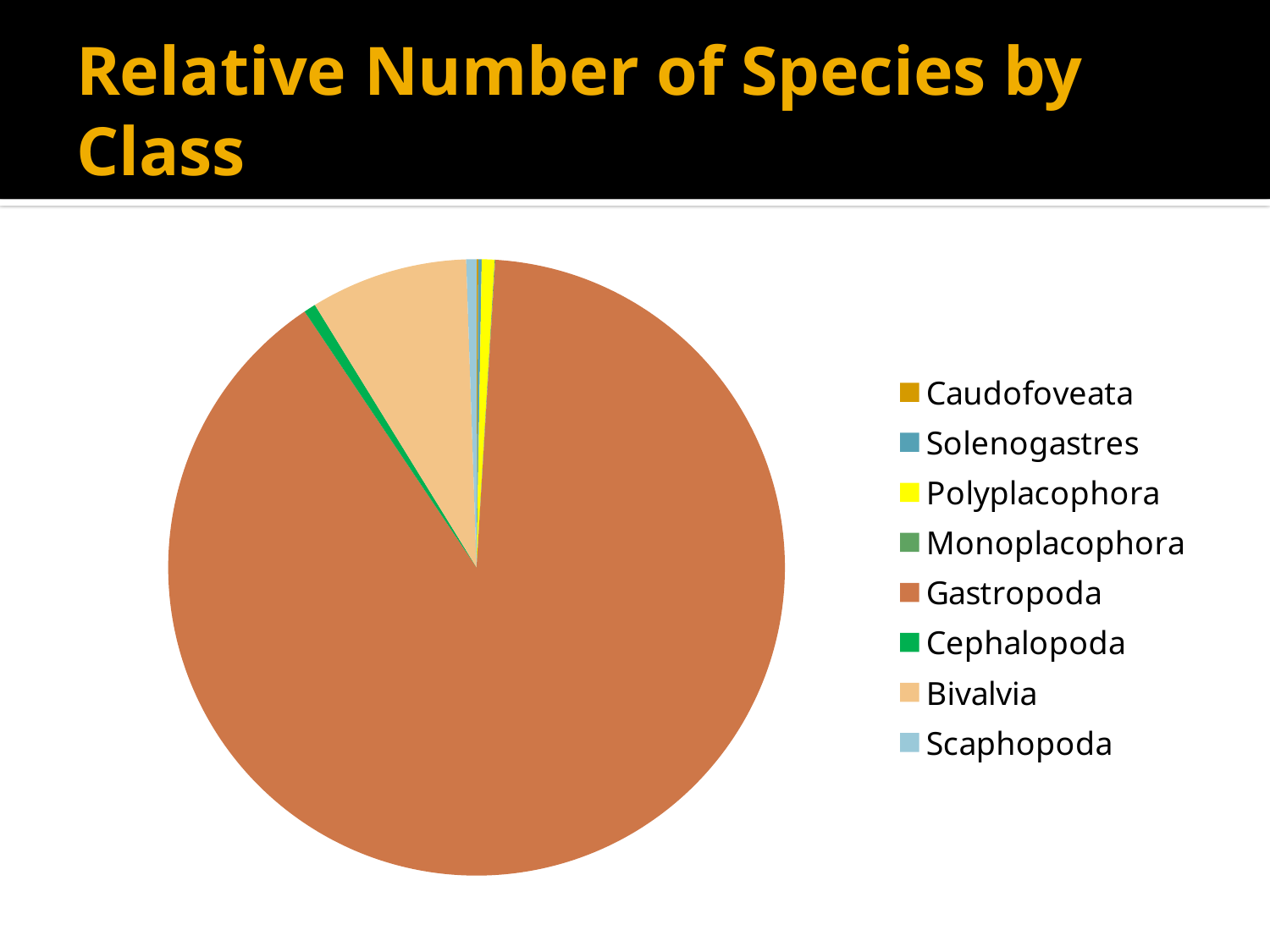
Which slice is larger, Bivalvia or Polyplacophora? Bivalvia Which class has the second-largest slice of the pie chart? Bivalvia What kind of chart is shown on the slide? pie chart Is the share of the pie for Gastropoda greater or less than 50%? greater Which class has the largest slice of the pie chart? Gastropoda Which slice is larger, Gastropoda or Bivalvia? Gastropoda How many classes does the legend of the pie chart list? 8 What is the title of the chart on the slide? Relative Number of Species by Class Which class is listed first in the legend of the pie chart? Caudofoveata Which class is shown in yellow in the pie chart? Polyplacophora Which slice is larger, Bivalvia or Cephalopoda? Bivalvia